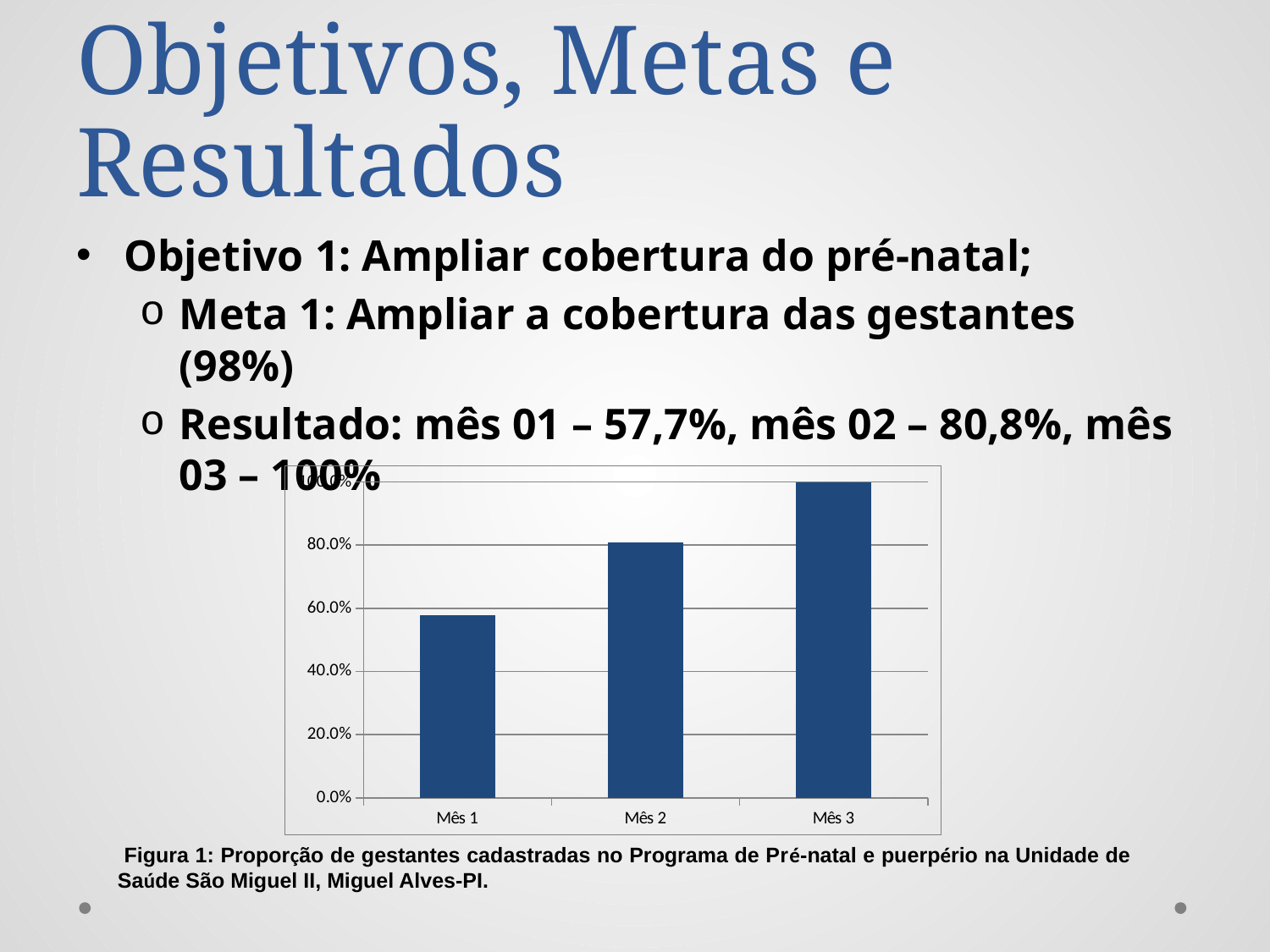
Is the value for Mês 1 greater or less than 60.0%? less What kind of chart is shown on the slide? bar chart Is the value for Mês 1 greater or less than 40.0%? greater Do the values rise or fall from Mês 1 to Mês 3? rise Which is larger, the value for Mês 1 or the value for Mês 2? Mês 2 Which month has the highest bar in the chart? Mês 3 Is the value for Mês 2 greater or less than 60.0%? greater Which month has the lowest bar in the chart? Mês 1 What is the highest tick value shown on the y axis of the chart? 100.0% What is the label of the first category on the x axis? Mês 1 How many categories are plotted on the x axis of the chart? 3